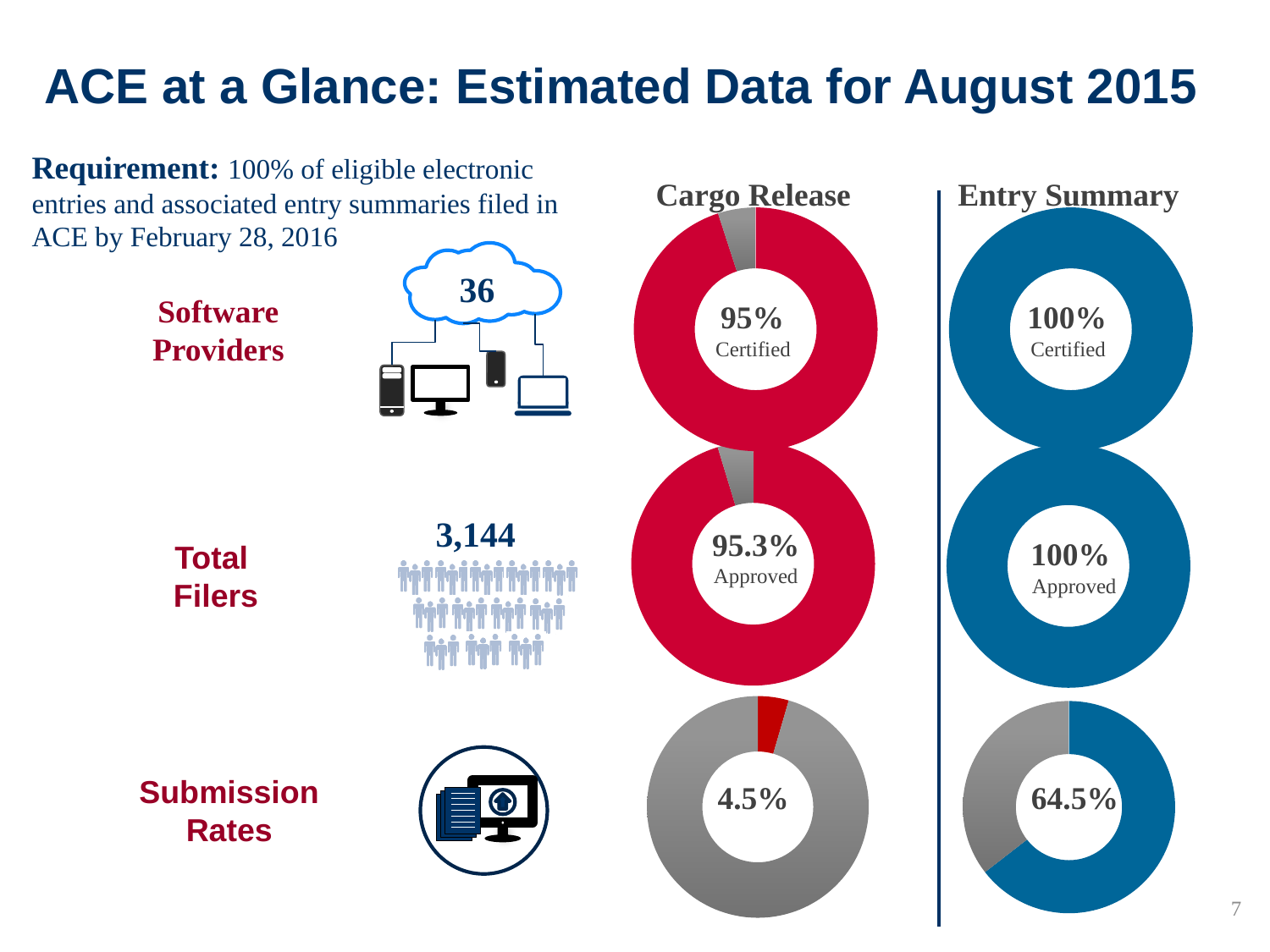
In the Entry Summary column, what percentage is shown as Approved in the middle donut chart? 100% What kind of chart is used to show the Cargo Release and Entry Summary percentages? Donut (pie) chart In the Cargo Release column, what percentage is shown as Approved in the middle donut chart? 95.3% In the Entry Summary column, what submission rate is shown in the bottom donut chart? 64.5% Which has the higher submission rate in the bottom donut charts, Cargo Release or Entry Summary? Entry Summary In the Entry Summary column, what percentage is shown as Certified in the top donut chart? 100% How many donut charts are shown on the slide? 6 What is the difference between the Entry Summary submission rate and the Cargo Release submission rate shown in the bottom donut charts? 60% In the Cargo Release column, what percentage is shown as Certified in the top donut chart? 95% In the Cargo Release column, what submission rate is shown in the bottom donut chart? 4.5% What is the difference between the Entry Summary Certified percentage and the Cargo Release Certified percentage in the top donut charts? 5% What colour are the Entry Summary donut charts? Blue